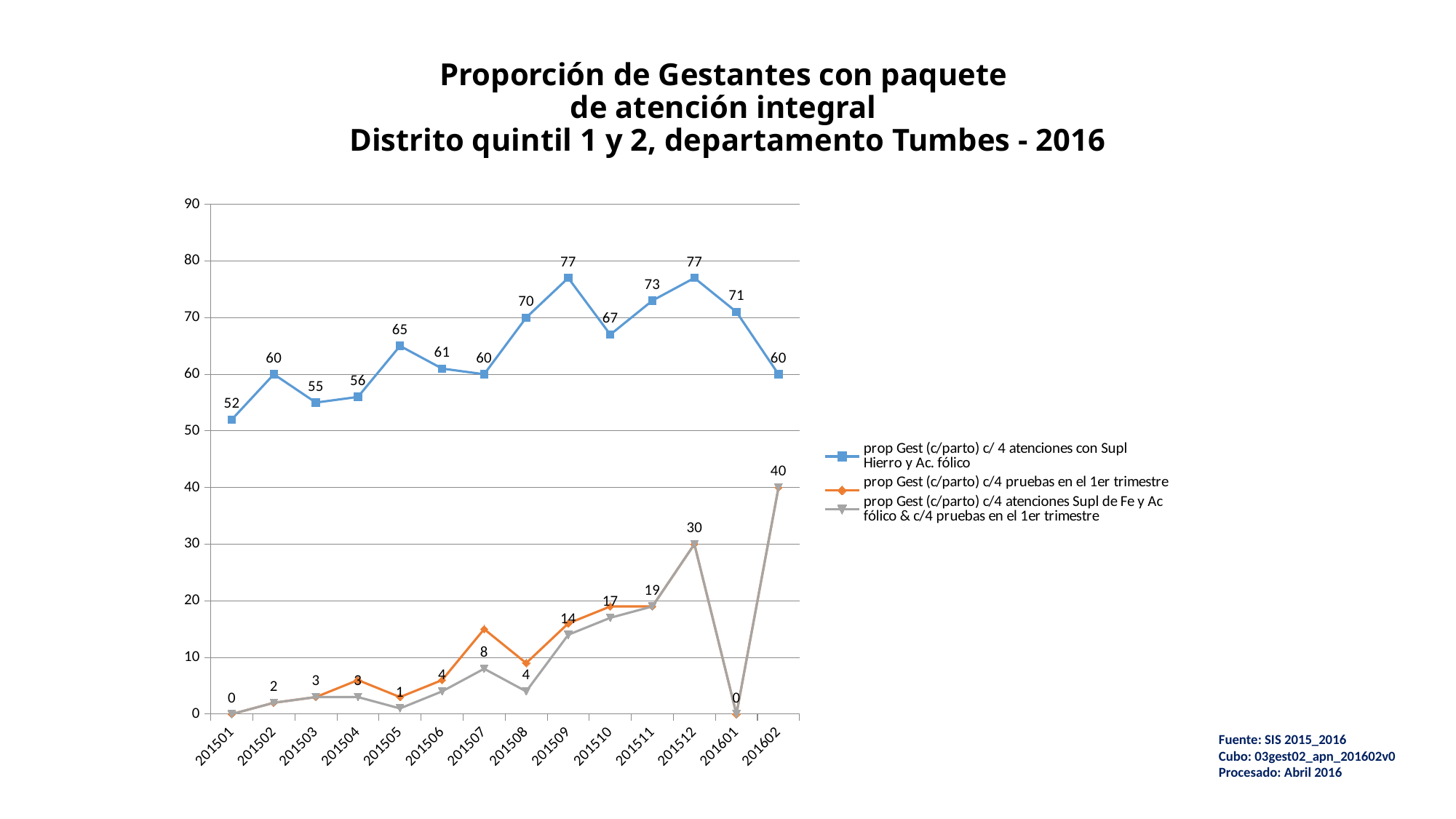
How many time periods are shown on the x axis? 14 What is the value of the series 'prop Gest (c/parto) c/4 atenciones Supl de Fe y Ac fólico & c/4 pruebas en el 1er trimestre' at 201507? 8 How many series does the legend list? 3 What is the difference between the values of the series 'prop Gest (c/parto) c/ 4 atenciones con Supl Hierro y Ac. fólico' at 201509 and at 201501? 25 What is the value of the series 'prop Gest (c/parto) c/ 4 atenciones con Supl Hierro y Ac. fólico' at 201512? 77 What is the value of the series 'prop Gest (c/parto) c/ 4 atenciones con Supl Hierro y Ac. fólico' at 201501? 52 What kind of chart is shown on the slide? line chart Is the value of the series 'prop Gest (c/parto) c/4 pruebas en el 1er trimestre' at 201507 greater or less than 10? greater What is the highest value reached by the series 'prop Gest (c/parto) c/ 4 atenciones con Supl Hierro y Ac. fólico'? 77 At which period is the series 'prop Gest (c/parto) c/ 4 atenciones con Supl Hierro y Ac. fólico' lowest? 201501 What is the value of the series 'prop Gest (c/parto) c/4 atenciones Supl de Fe y Ac fólico & c/4 pruebas en el 1er trimestre' at 201602? 40 For the series 'prop Gest (c/parto) c/ 4 atenciones con Supl Hierro y Ac. fólico', which period has the larger value, 201505 or 201506? 201505